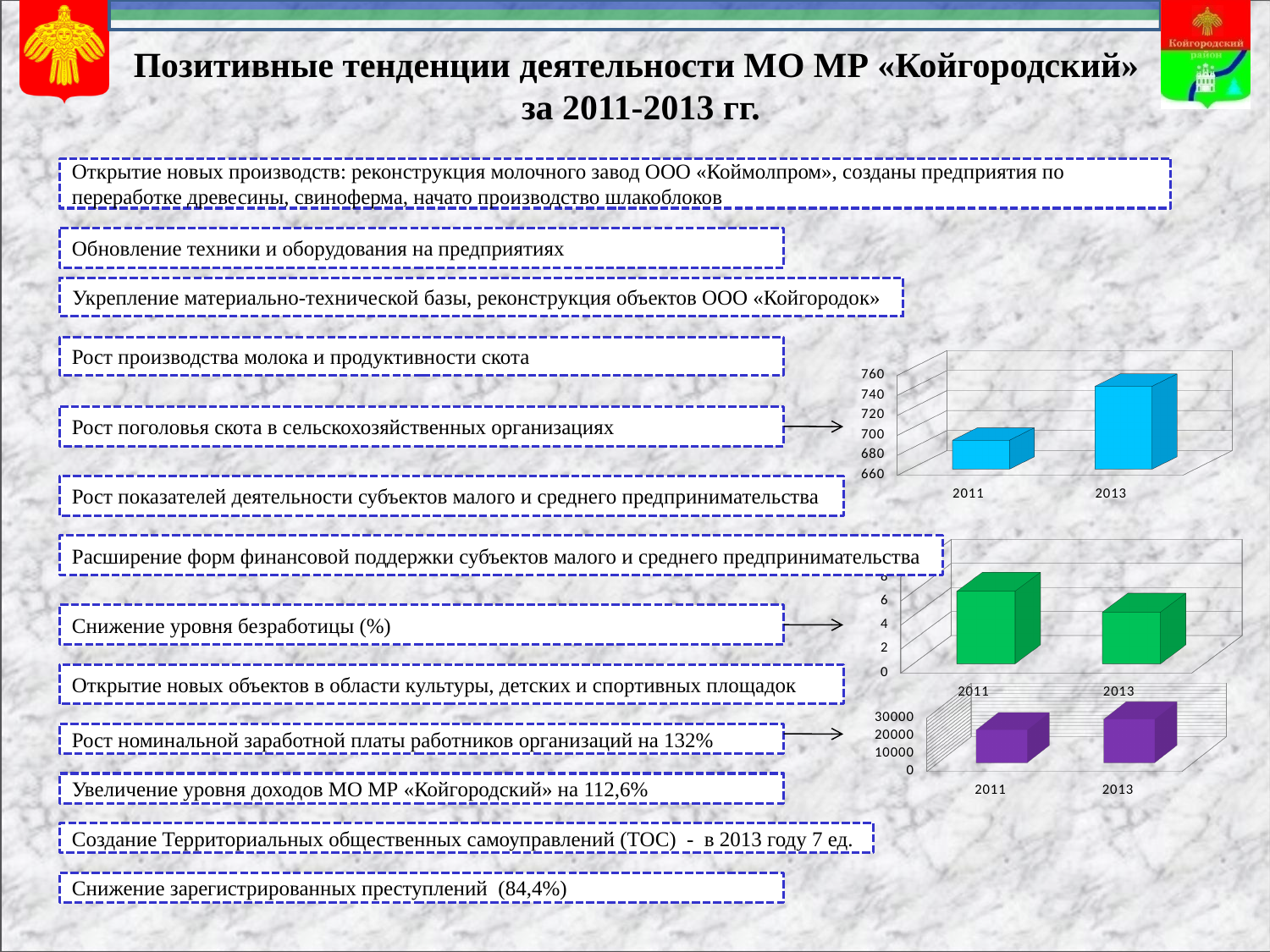
In the middle chart (green bars), do the values rise or fall from 2011 to 2013? fall What colour are the bars in the bottom chart? purple In the top chart, do the values rise or fall from 2011 to 2013? rise What kind of chart is the top chart on the right of the slide? bar chart In the top chart, is the value for 2011 greater or less than 720? less In the top chart, is the value for 2013 greater or less than 720? greater In the top chart, which year has the larger value, 2011 or 2013? 2013 In the middle chart (green bars), is the value for 2011 greater or less than 4? greater How many categories are shown on the x axis of the top chart? 2 In the bottom chart (purple bars), which year has the larger value, 2011 or 2013? 2013 In the middle chart (green bars), which year has the higher value? 2011